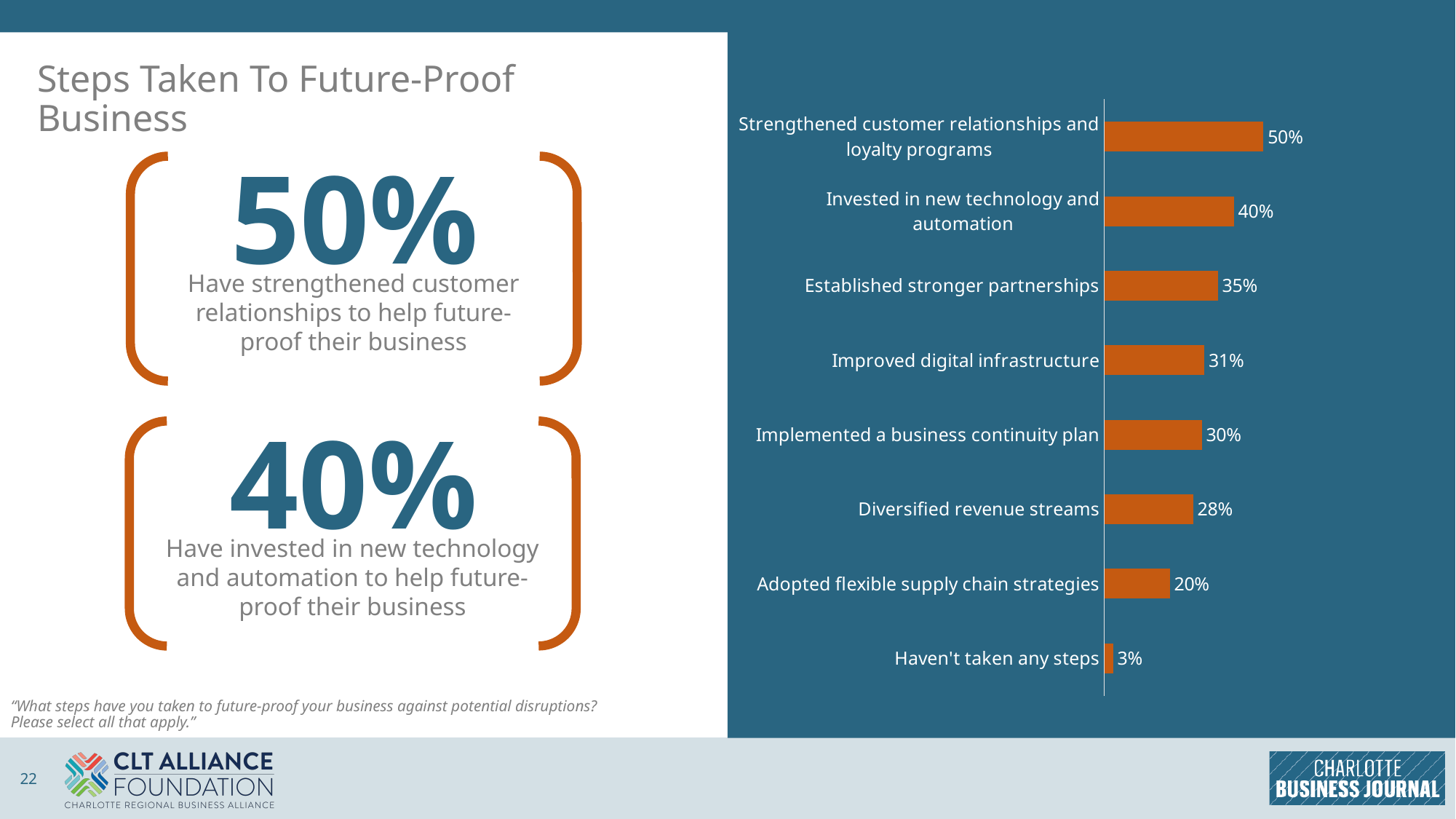
What is the difference between 'Diversified revenue streams' and 'Haven't taken any steps'? 25% What is the difference between 'Invested in new technology and automation' and 'Established stronger partnerships'? 5% Do the values rise or fall going from the top bar to the bottom bar? Fall What type of chart is shown on the slide? Bar chart Which is larger: 'Implemented a business continuity plan' or 'Diversified revenue streams'? Implemented a business continuity plan What percentage of respondents strengthened customer relationships and loyalty programs? 50% What colour are the bars in the chart? Orange What is the value for 'Improved digital infrastructure'? 31% Which category has the lowest value? Haven't taken any steps What percentage adopted flexible supply chain strategies? 20% Which step has the highest percentage? Strengthened customer relationships and loyalty programs How many categories are shown in the bar chart? 8